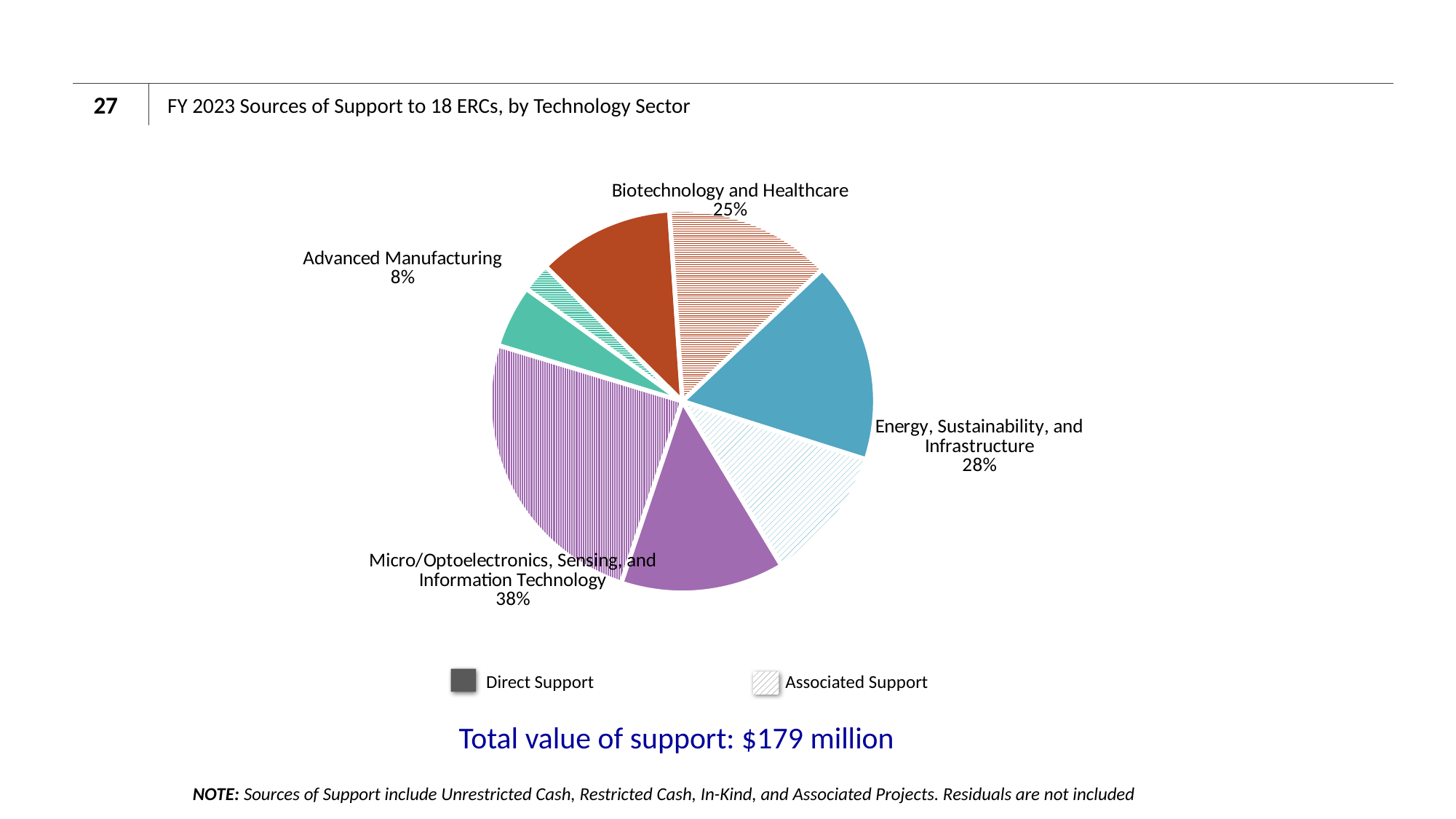
Which technology sector has the largest share of support? Micro/Optoelectronics, Sensing, and Information Technology Which has a larger share: Energy, Sustainability, and Infrastructure or Biotechnology and Healthcare? Energy, Sustainability, and Infrastructure What kind of chart is shown on the slide? Pie chart What percentage is shown for Energy, Sustainability, and Infrastructure? 28% What share of support goes to the Micro/Optoelectronics, Sensing, and Information Technology sector? 38% What percentage is shown for Advanced Manufacturing? 8% What is the total value of support stated below the chart? $179 million How many entries does the legend list? 2 How many technology sectors are labelled on the pie chart? 4 What percentage is shown for Biotechnology and Healthcare? 25% Which technology sector has the smallest share of support? Advanced Manufacturing How many percentage points larger is the Micro/Optoelectronics, Sensing, and Information Technology share than the Biotechnology and Healthcare share? 13 percentage points